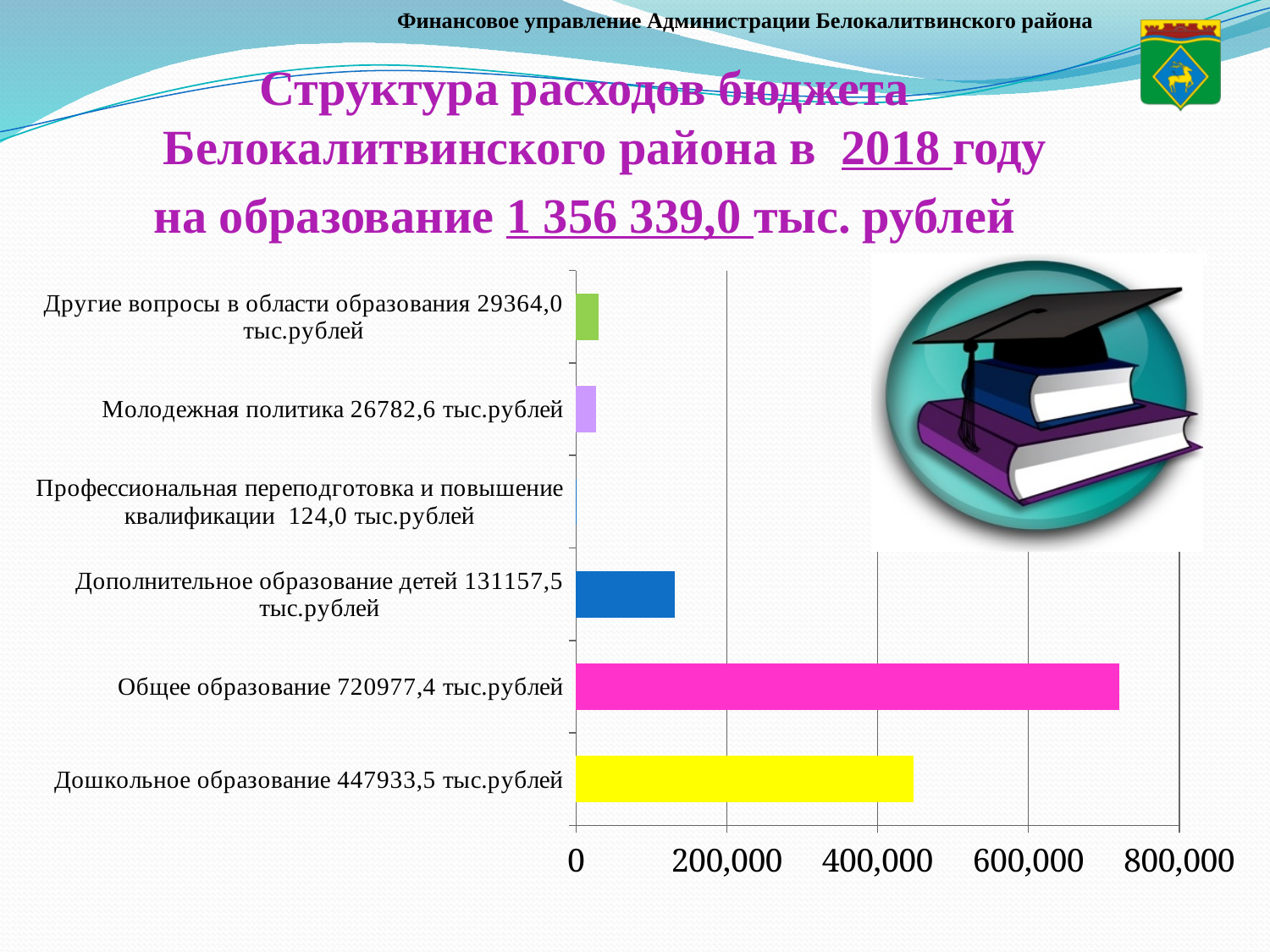
Which category has the lowest value? Профессиональная переподготовка и повышение квалификации What is the difference between Другие вопросы в области образования and Молодежная политика? 2581,4 тыс.рублей What value is shown for Дошкольное образование? 447933,5 тыс.рублей How many categories are shown in the chart? 6 What value is shown for Общее образование? 720977,4 тыс.рублей Is the value for Общее образование greater or less than 600,000? greater Which is larger, Дошкольное образование or Дополнительное образование детей? Дошкольное образование What value is shown for Профессиональная переподготовка и повышение квалификации? 124,0 тыс.рублей What kind of chart is shown on the slide? bar chart What is the difference between Общее образование and Дошкольное образование? 273043,9 тыс.рублей Which category has the highest value? Общее образование What value is shown for Дополнительное образование детей? 131157,5 тыс.рублей